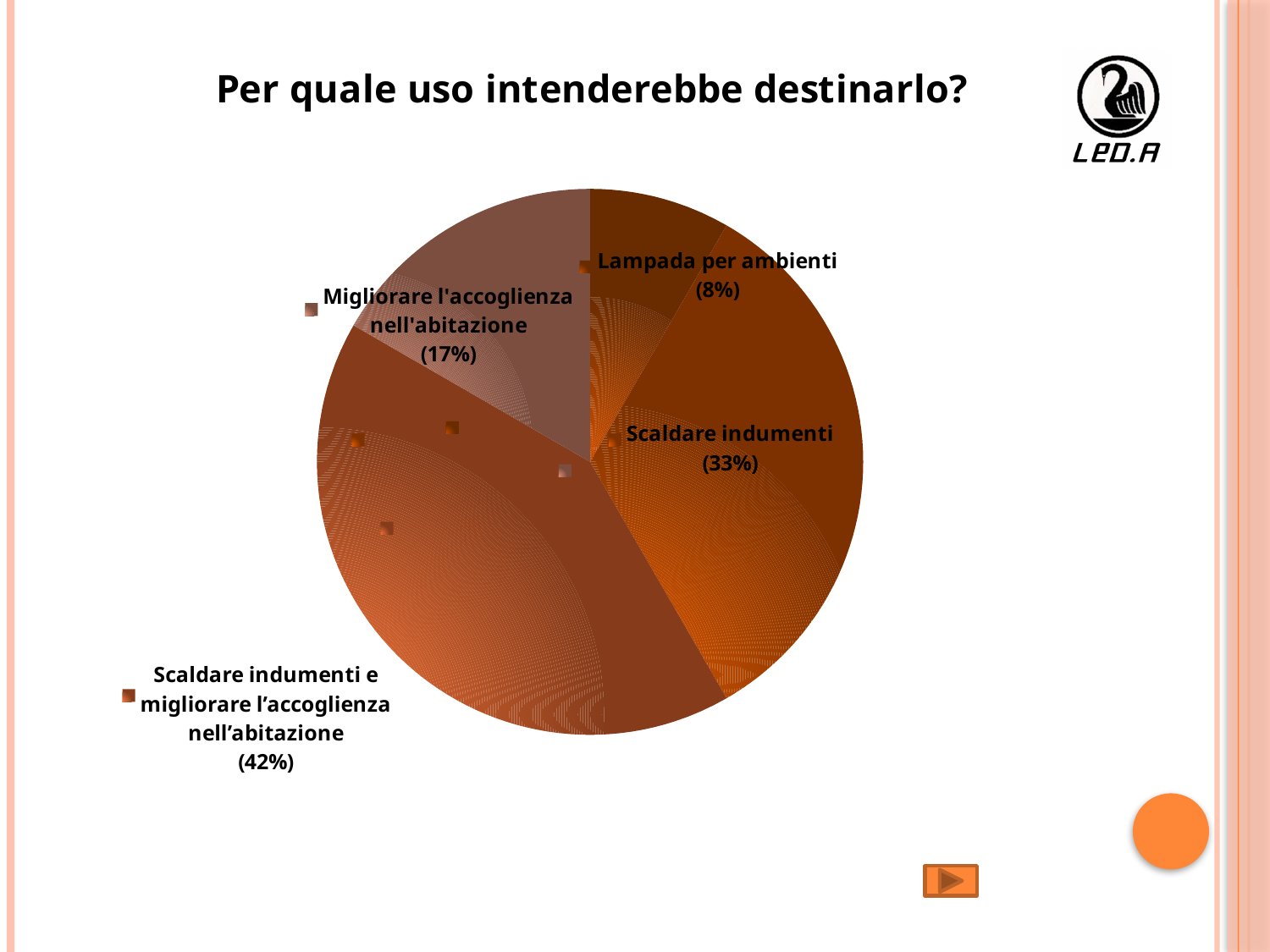
What is the difference in percentage points between the largest and smallest slices? 34 What is the title of the chart? Per quale uso intenderebbe destinarlo? What kind of chart is shown on the slide? pie chart How many slices does the pie chart have? 4 What share of the pie is 'Migliorare l'accoglienza nell'abitazione'? 17% Which category has the largest share of the pie? Scaldare indumenti e migliorare l'accoglienza nell'abitazione What share of the pie is 'Scaldare indumenti'? 33% Which category has the smallest share of the pie? Lampada per ambienti What share of the pie is 'Scaldare indumenti e migliorare l'accoglienza nell'abitazione'? 42% What is the difference in percentage points between 'Scaldare indumenti' and 'Migliorare l'accoglienza nell'abitazione'? 16 Which is larger: the share for 'Scaldare indumenti' or the share for 'Lampada per ambienti'? Scaldare indumenti